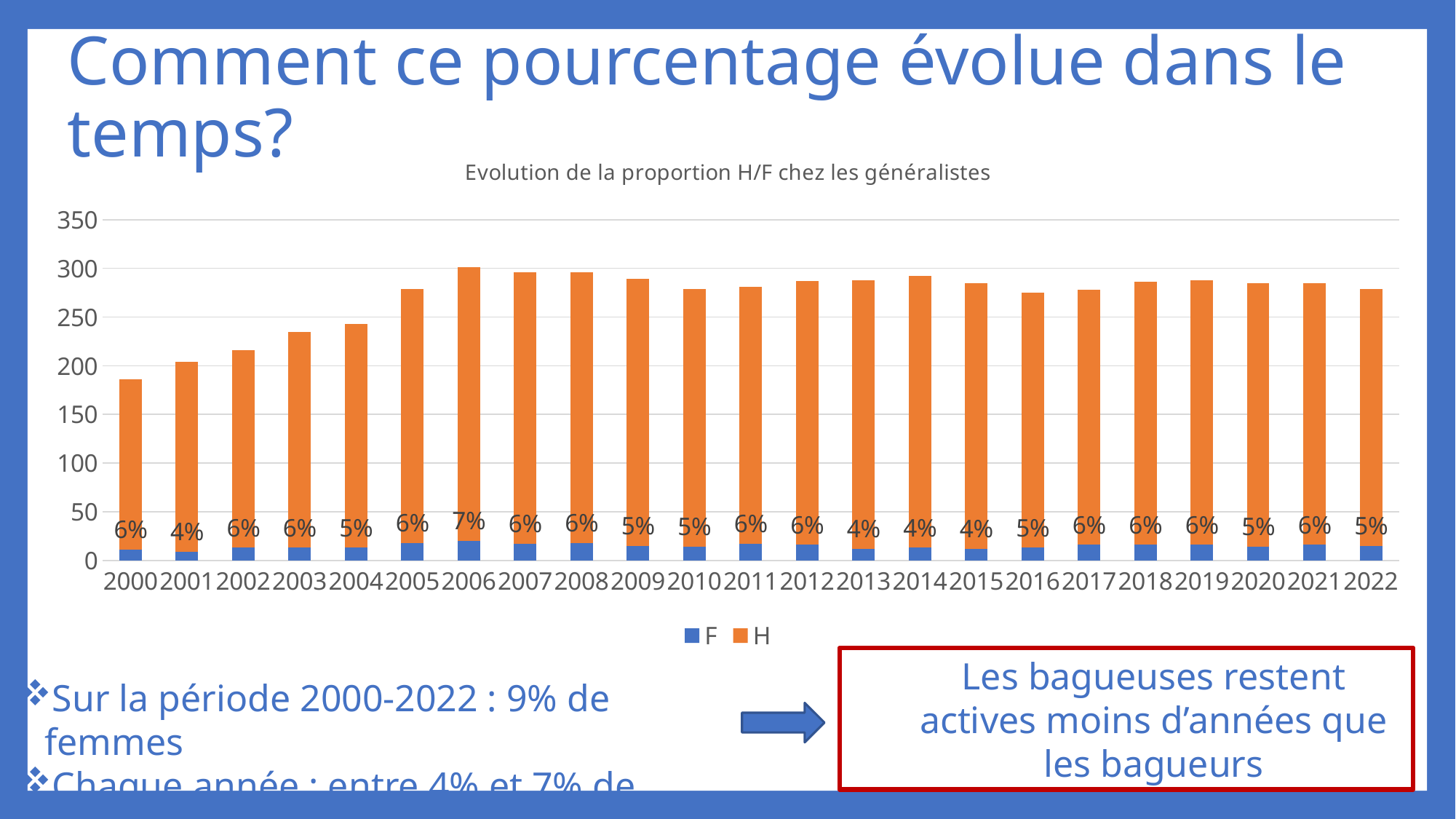
How many years are shown along the x axis of the chart? 23 Do the total bar heights rise or fall from 2000 to 2006? rise What kind of chart is shown on the slide? stacked bar chart What percentage label is shown for the year 2006? 7% What percentage label is shown for the year 2022? 5% Which year has a taller total bar, 2000 or 2006? 2006 Is the total bar height for 2000 greater or less than 200? less What percentage label is shown for the year 2001? 4% What is the title of the chart? Evolution de la proportion H/F chez les généralistes How many series does the chart legend list? 2 Which year has the highest percentage label on the chart? 2006